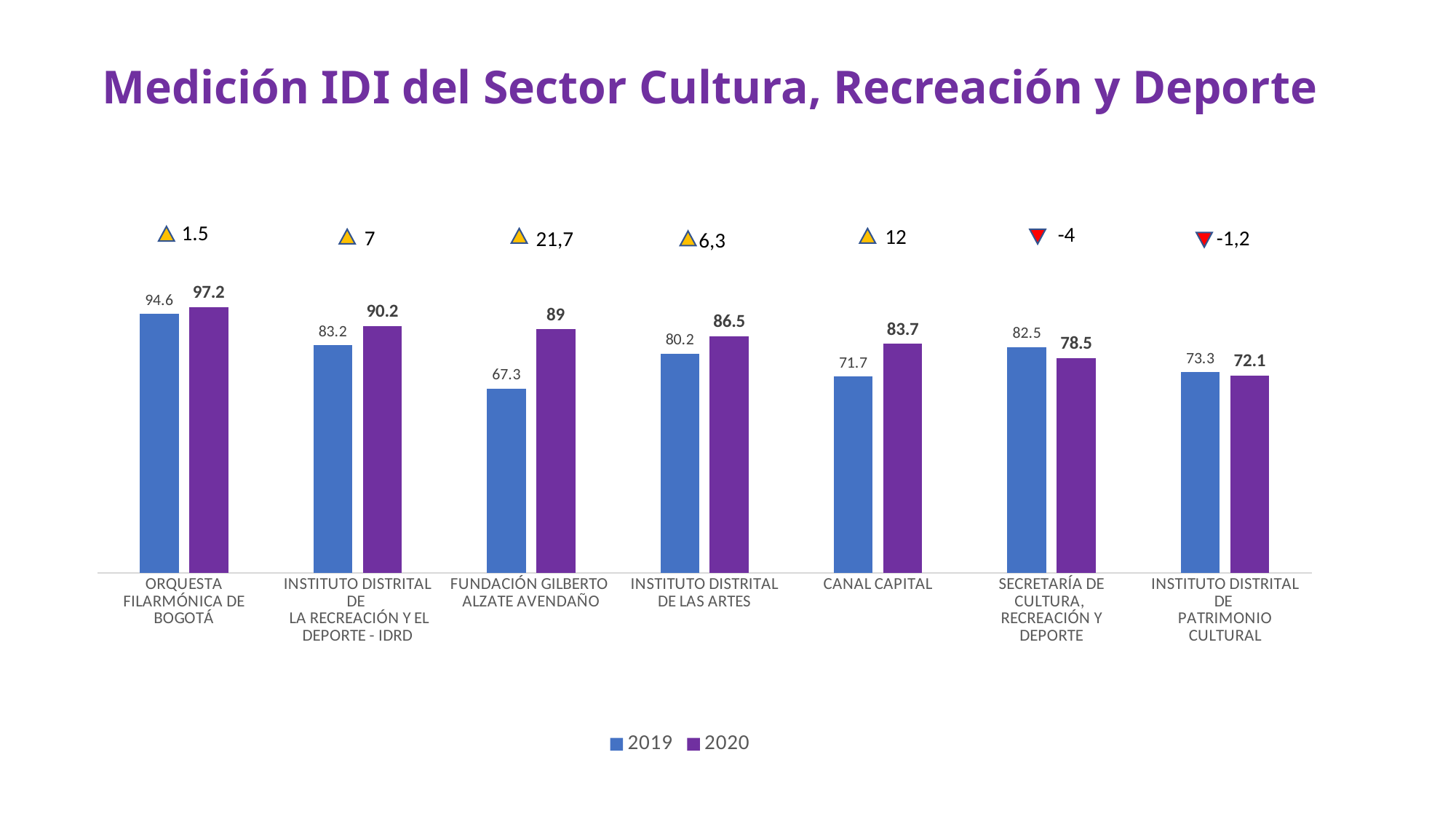
How many series does the legend list? 2 What is the 2020 value for Orquesta Filarmónica de Bogotá? 97.2 Which entity has the lowest 2019 value? Fundación Gilberto Alzate Avendaño What is the title of the chart? Medición IDI del Sector Cultura, Recreación y Deporte Which colour represents the 2020 series? Purple What is the 2019 value for Fundación Gilberto Alzate Avendaño? 67.3 What kind of chart is shown on the slide? Bar chart What is the 2020 value for Canal Capital? 83.7 Which entity has the highest 2020 value? Orquesta Filarmónica de Bogotá What is the difference between the 2020 and 2019 values for Instituto Distrital de las Artes? 6.3 Which is larger for Secretaría de Cultura, Recreación y Deporte: the 2019 value or the 2020 value? 2019 How many entities are shown on the x axis? 7